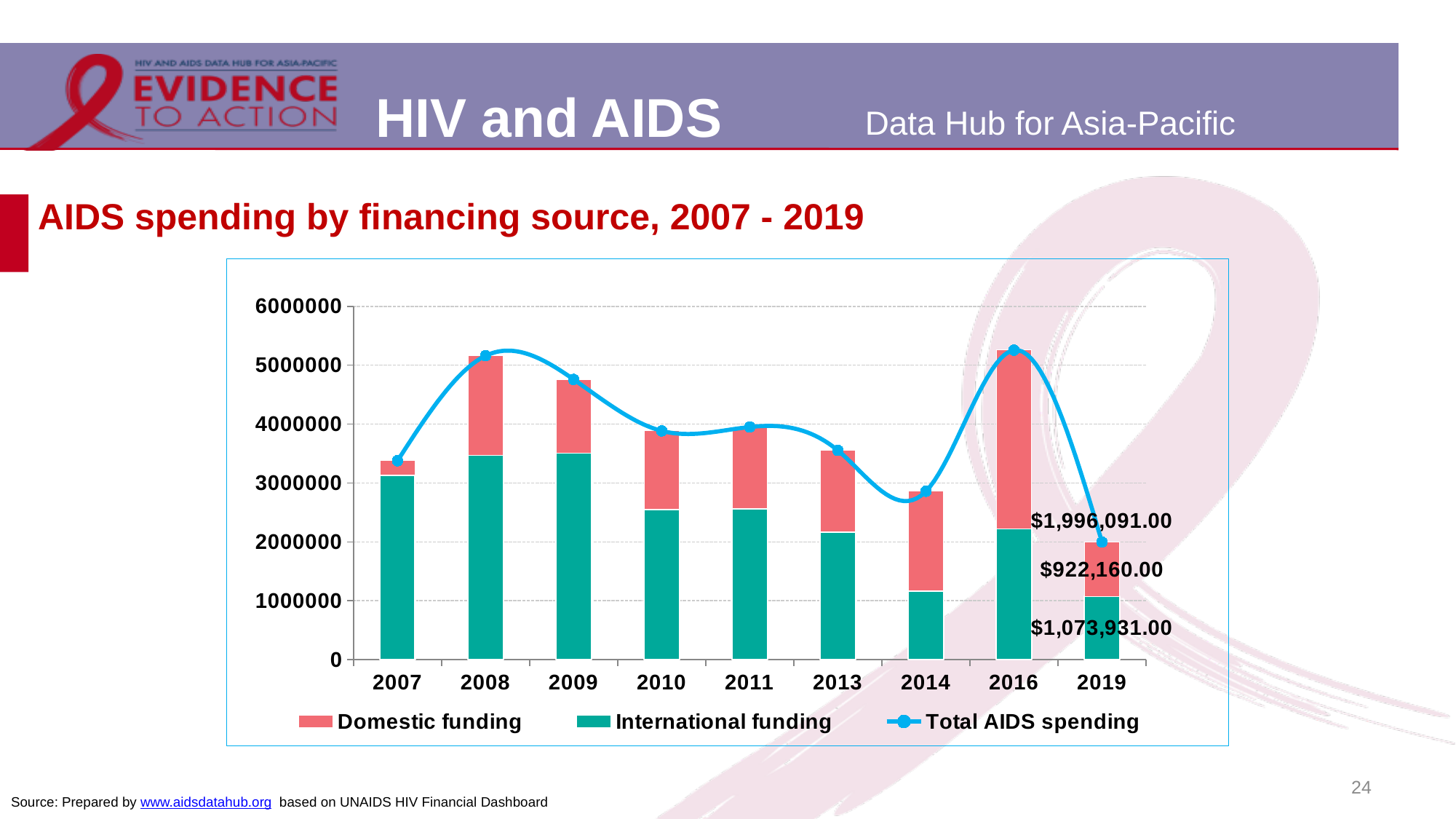
Which year has the lowest Total AIDS spending? 2019 What is the Total AIDS spending value labelled for 2019? $1,996,091.00 What is the title of the chart? AIDS spending by financing source, 2007 - 2019 What is the difference between International funding and Domestic funding in 2019? $151,771.00 How many years are shown on the x axis of the chart? 9 What is the International funding value labelled for 2019? $1,073,931.00 Is the Total AIDS spending for 2013 greater or less than 4000000? less In 2019, which is larger: Domestic funding or International funding? International funding Is the Total AIDS spending for 2007 greater or less than 3000000? greater What is the Domestic funding value labelled for 2019? $922,160.00 How many series does the chart legend list? 3 What kind of chart is shown on the slide? A stacked bar chart with a line